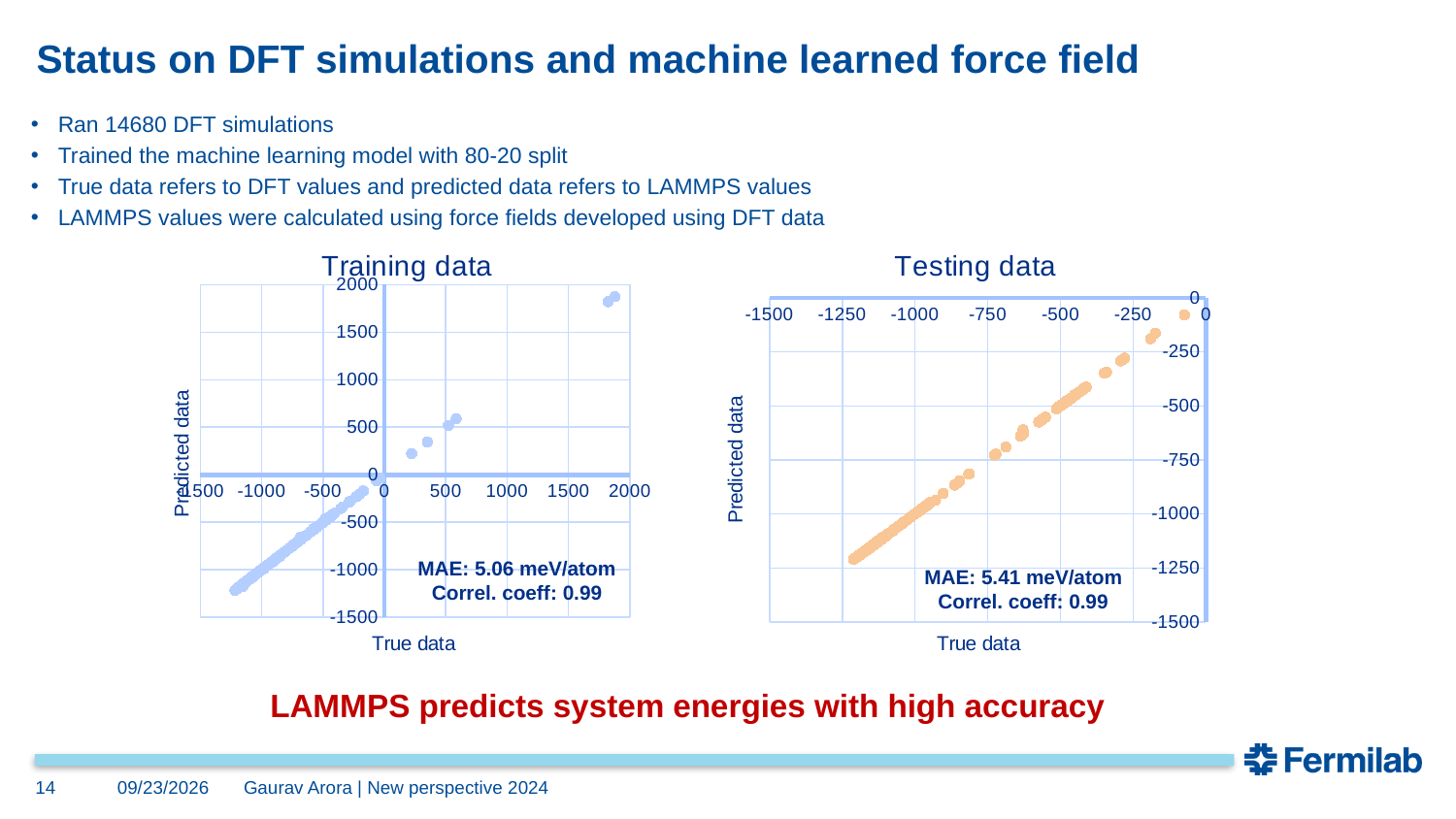
What kind of chart is the Testing data chart? Scatter chart What kind of chart is the Training data chart? Scatter chart In the Training data chart, is the lowest predicted value greater or less than -1000? less What is the x-axis label of the Testing data chart? True data What is the MAE shown on the Testing data chart? 5.41 meV/atom What is the MAE shown on the Training data chart? 5.06 meV/atom In the Testing data chart, do the predicted values rise or fall as the true data increases along the x axis? Rise In the Testing data chart, is the highest predicted value greater or less than -250? greater In the Training data chart, do the predicted values rise or fall as the true data increases along the x axis? Rise What is the y-axis label of the Training data chart? Predicted data In the Testing data chart, is the lowest predicted value greater or less than -1000? less